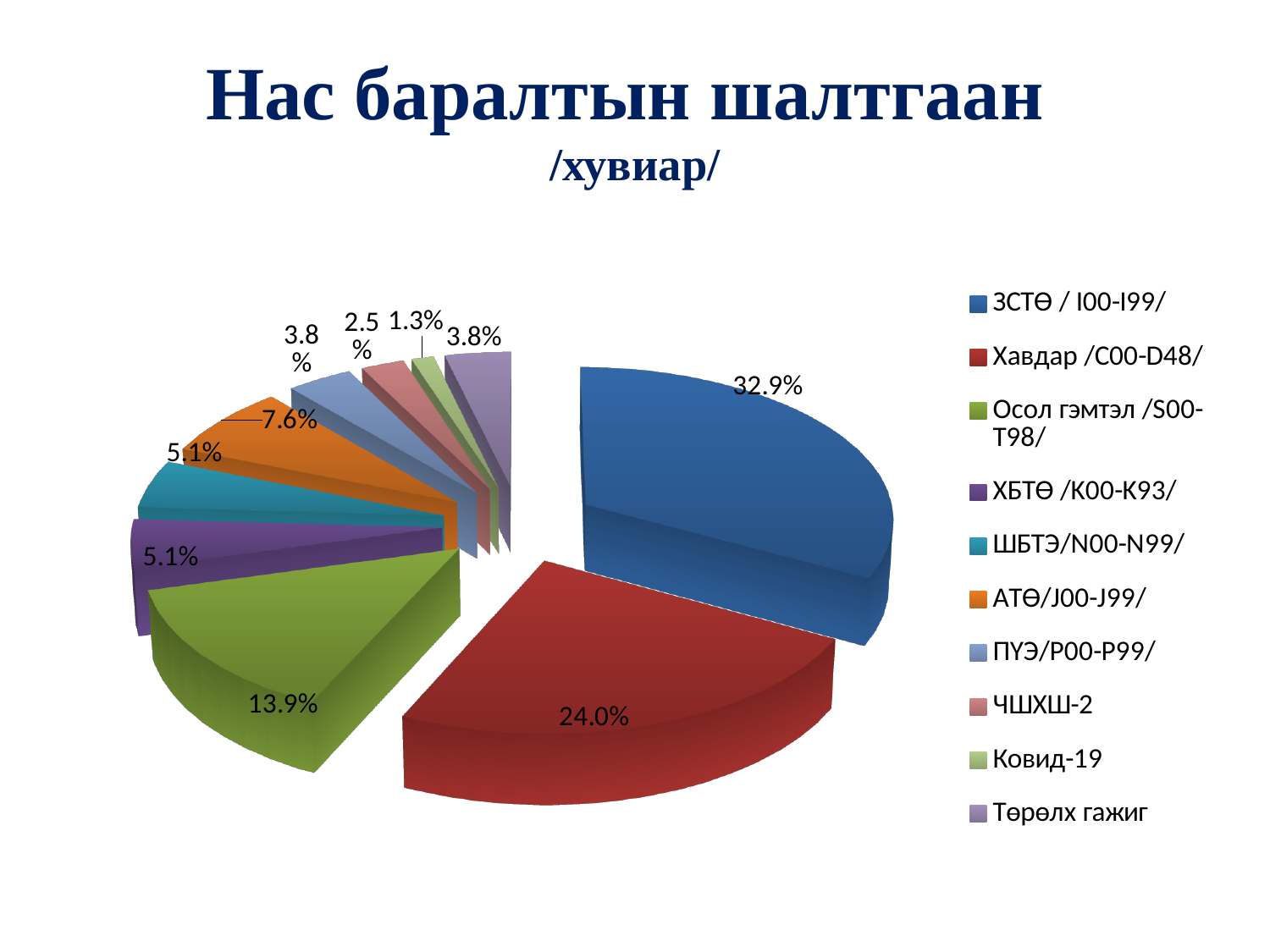
What kind of chart is shown on the slide? pie chart What share of the pie does Ковид-19 have? 1.3% What share of the pie does АТӨ/J00-J99/ have? 7.6% What is the difference between the shares of ЗСТӨ / I00-I99/ and Хавдар /C00-D48/? 8.9% Which is larger, the share of Осол гэмтэл /S00-T98/ or the share of АТӨ/J00-J99/? Осол гэмтэл /S00-T98/ Which category has the largest slice of the pie? ЗСТӨ / I00-I99/ What share of the pie does ЗСТӨ / I00-I99/ have? 32.9% What is the title of the chart on the slide? Нас баралтын шалтгаан /хувиар/ What share of the pie does Хавдар /C00-D48/ have? 24.0% Which category has the smallest slice of the pie? Ковид-19 How many categories does the legend of the pie chart list? 10 What share of the pie does Осол гэмтэл /S00-T98/ have? 13.9%